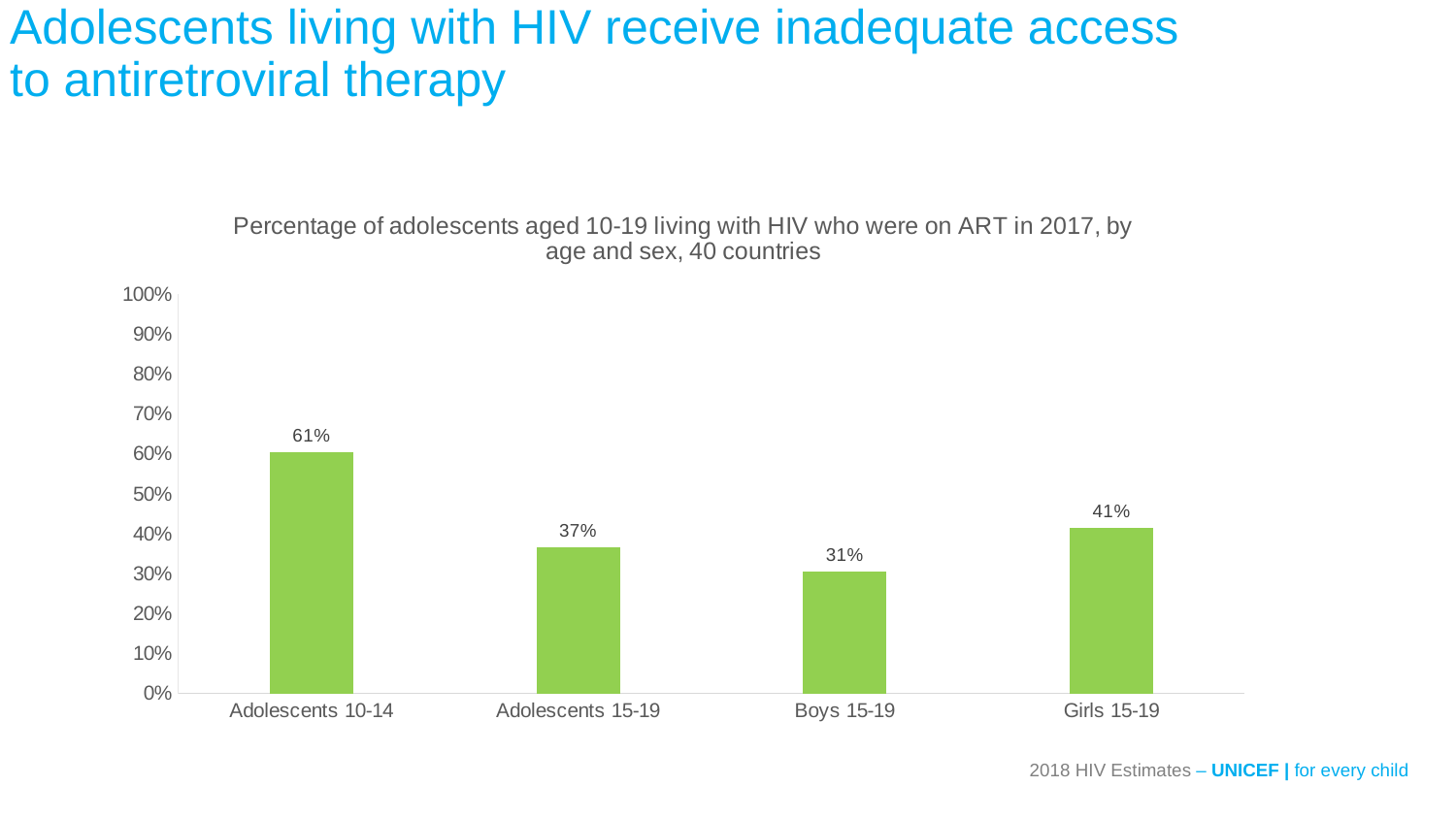
What is the title of the chart? Percentage of adolescents aged 10-19 living with HIV who were on ART in 2017, by age and sex, 40 countries Which is larger, the value for Girls 15-19 or the value for Boys 15-19? Girls 15-19 What is the value shown for Boys 15-19? 31% Which category has the highest percentage on ART? Adolescents 10-14 Which category has the lowest percentage on ART? Boys 15-19 What is the difference in percentage points between Girls 15-19 and Boys 15-19? 10 percentage points What is the value shown for Girls 15-19? 41% What kind of chart is shown on the slide? Bar chart What is the difference in percentage points between Adolescents 10-14 and Adolescents 15-19? 24 percentage points What percentage of adolescents aged 10-14 living with HIV were on ART in 2017? 61% How many categories are shown on the x axis of the chart? 4 What is the value shown for Adolescents 15-19? 37%